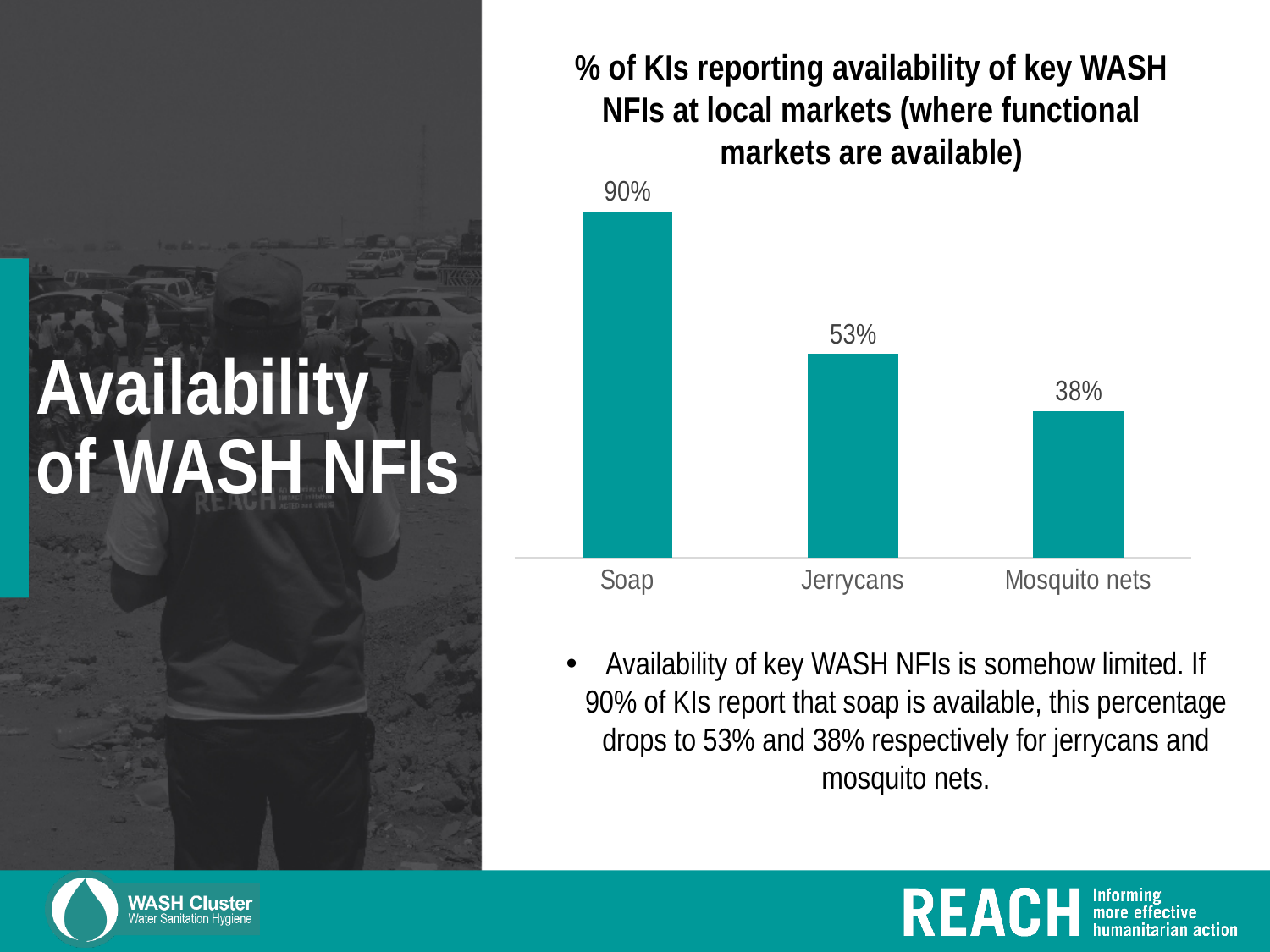
What is the difference in percentage points between the availability of jerrycans and mosquito nets? 15 How many WASH NFI categories are shown in the chart? 3 What is the difference in percentage points between the availability of soap and jerrycans? 37 What percentage of KIs reported jerrycans being available at local markets? 53% What type of chart is used to show the availability of WASH NFIs? Bar chart Which has a higher reported availability, jerrycans or mosquito nets? Jerrycans Do the values rise or fall moving from Soap to Mosquito nets along the x axis? Fall What percentage of KIs reported soap being available at local markets? 90% Which WASH NFI has the highest reported availability? Soap What percentage of KIs reported mosquito nets being available at local markets? 38% Which WASH NFI has the lowest reported availability? Mosquito nets What is the title of the chart? % of KIs reporting availability of key WASH NFIs at local markets (where functional markets are available)